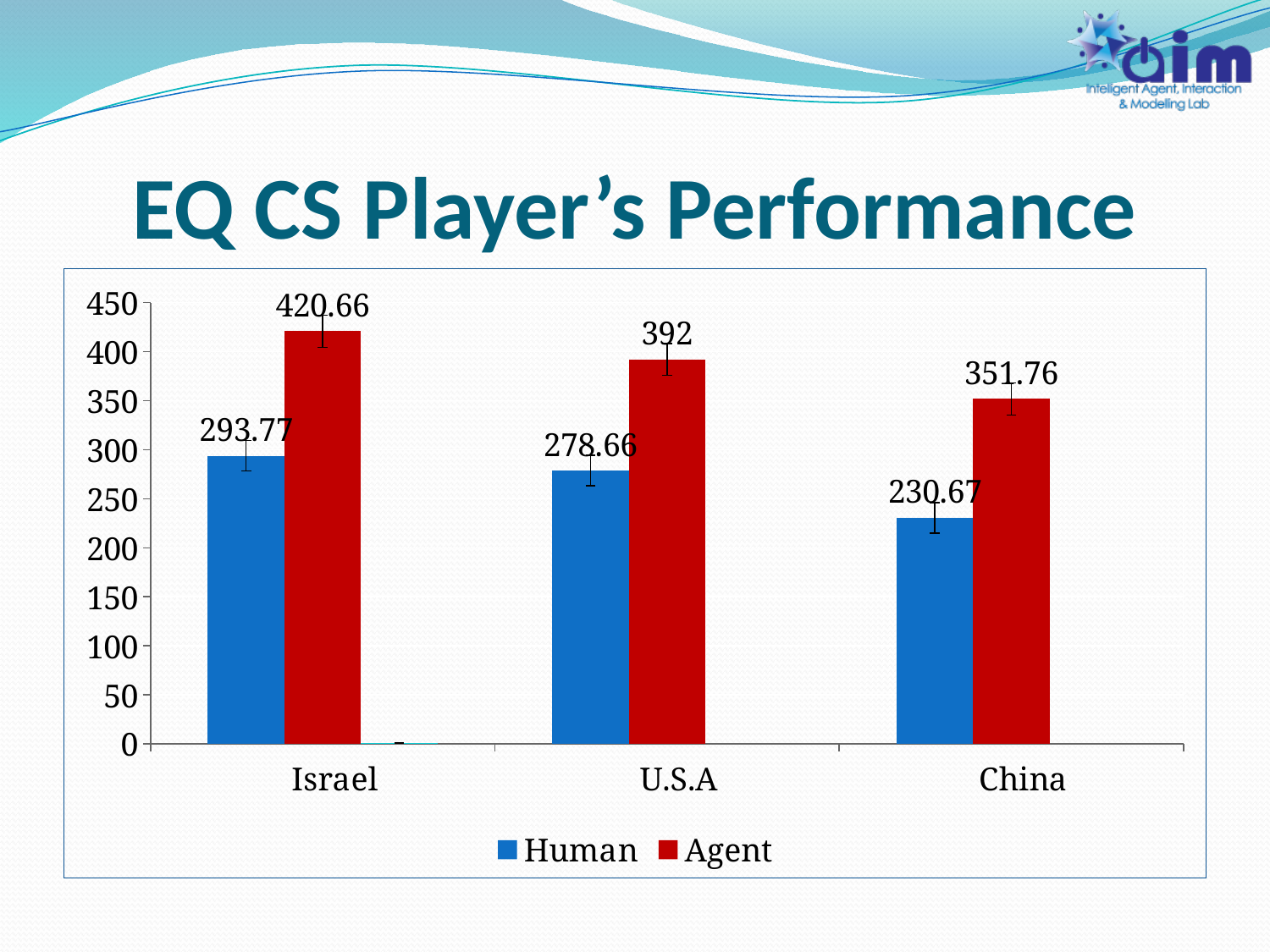
What is the Agent value for U.S.A? 392 What is the difference between the Human values for Israel and U.S.A? 15.11 Which is larger for U.S.A, the Human value or the Agent value? Agent What is the Agent value for China? 351.76 How many series does the legend list? 2 What is the difference between the Agent and Human values for Israel? 126.89 Which country has the lowest Human value? China What kind of chart is shown on the slide? Bar chart How many countries are shown on the x axis? 3 Which country has the highest Agent value? Israel What is the Human value for China? 230.67 What is the Human value for Israel? 293.77